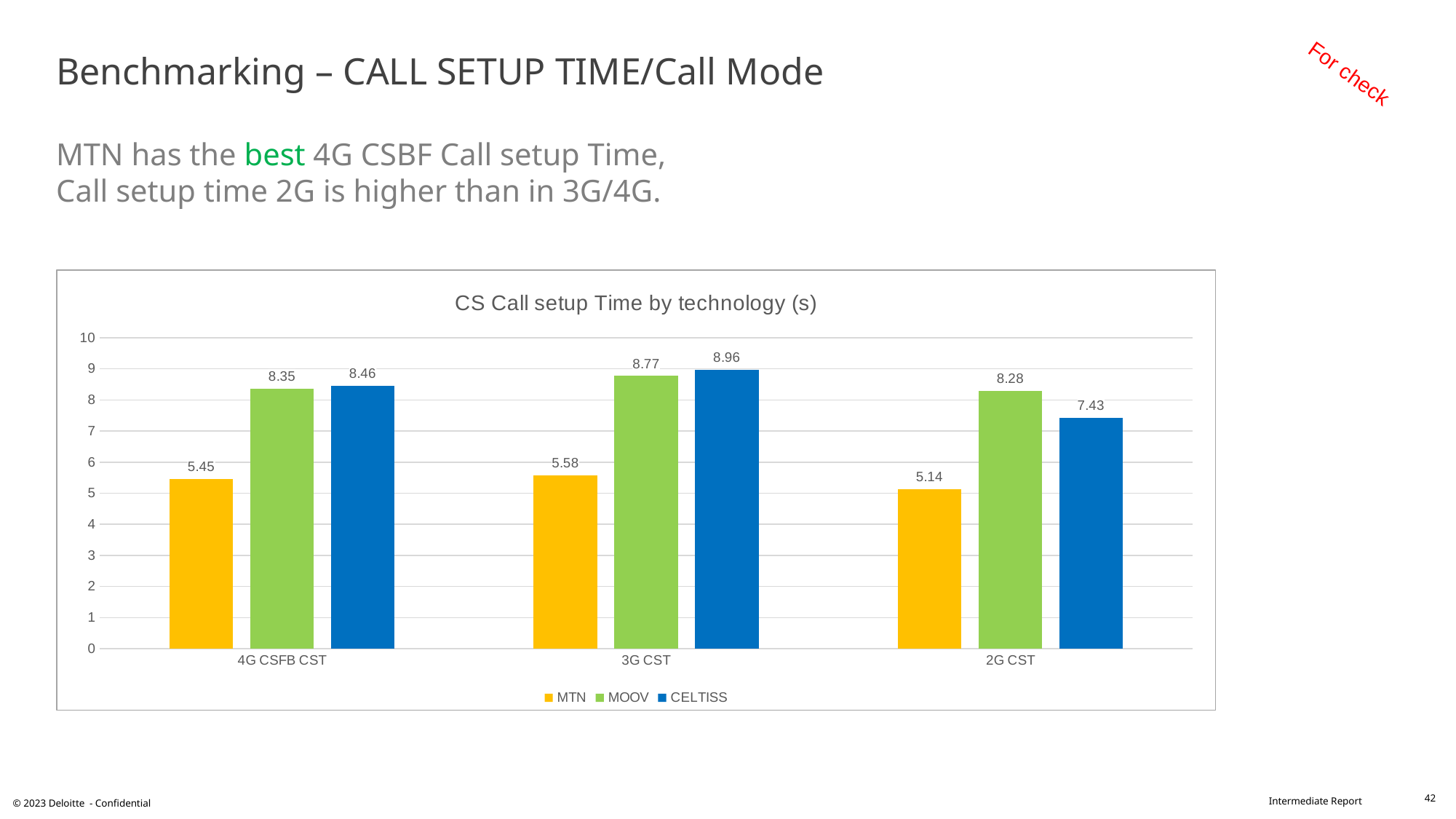
What is the MTN value for 4G CSFB CST? 5.45 What kind of chart is shown on the slide? bar chart Which is larger for 2G CST, the MOOV value or the CELTISS value? MOOV What is the MOOV value for 2G CST? 8.28 What is the CELTISS value for 3G CST? 8.96 Is the CELTISS value for 2G CST greater or less than 8? less How many technology categories are shown on the x axis? 3 How many series does the legend list? 3 Which operator has the highest call setup time for 3G CST? CELTISS What is the difference between the MOOV and MTN values for 3G CST? 3.19 Which operator has the lowest call setup time for 2G CST? MTN What is the title of the chart? CS Call setup Time by technology (s)